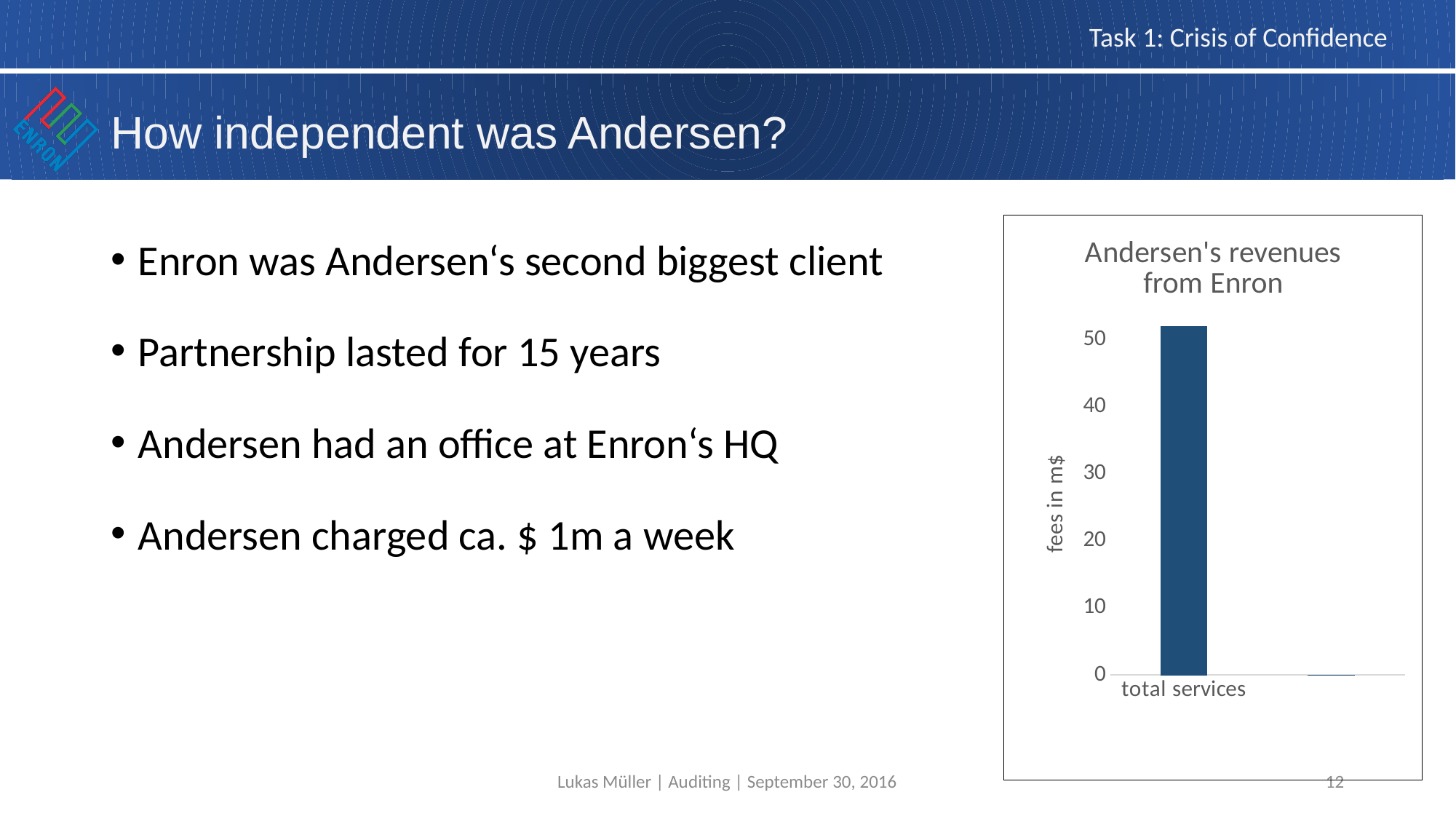
What is the highest tick value shown on the vertical axis of the chart? 50 Is the value for total services greater or less than 20? greater What is the title of the chart on the slide? Andersen's revenues from Enron Is the value for total services greater or less than 40? greater What kind of chart is shown on the slide? bar chart What is the label of the vertical axis of the chart? fees in m$ Is the value for total services greater or less than 30? greater